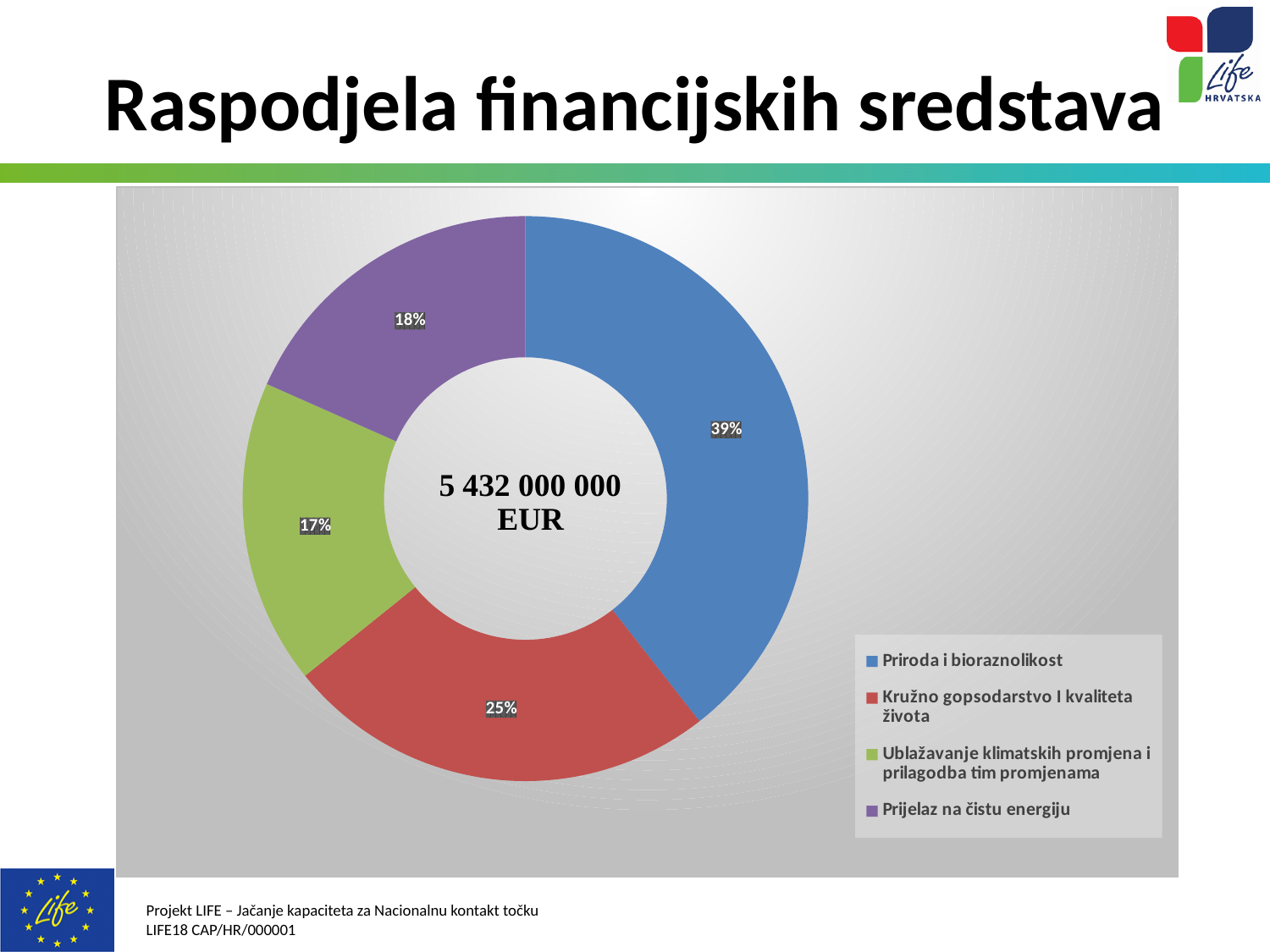
Which category has the largest share of the chart? Priroda i bioraznolikost What total amount is written in the centre of the chart? 5 432 000 000 EUR Which category has the smallest share of the chart? Ublažavanje klimatskih promjena i prilagodba tim promjenama How many categories does the chart show? 4 What percentage is shown for Kružno gopsodarstvo I kvaliteta života? 25% What share of the chart does Priroda i bioraznolikost take? 39% What percentage is shown for Ublažavanje klimatskih promjena i prilagodba tim promjenama? 17% What colour is the slice for Kružno gopsodarstvo I kvaliteta života? red Which is larger, the share for Prijelaz na čistu energiju or the share for Ublažavanje klimatskih promjena i prilagodba tim promjenama? Prijelaz na čistu energiju What kind of chart is shown on the slide? doughnut chart What is the difference in percentage points between Priroda i bioraznolikost and Kružno gopsodarstvo I kvaliteta života? 14 What share of the chart does Prijelaz na čistu energiju take? 18%